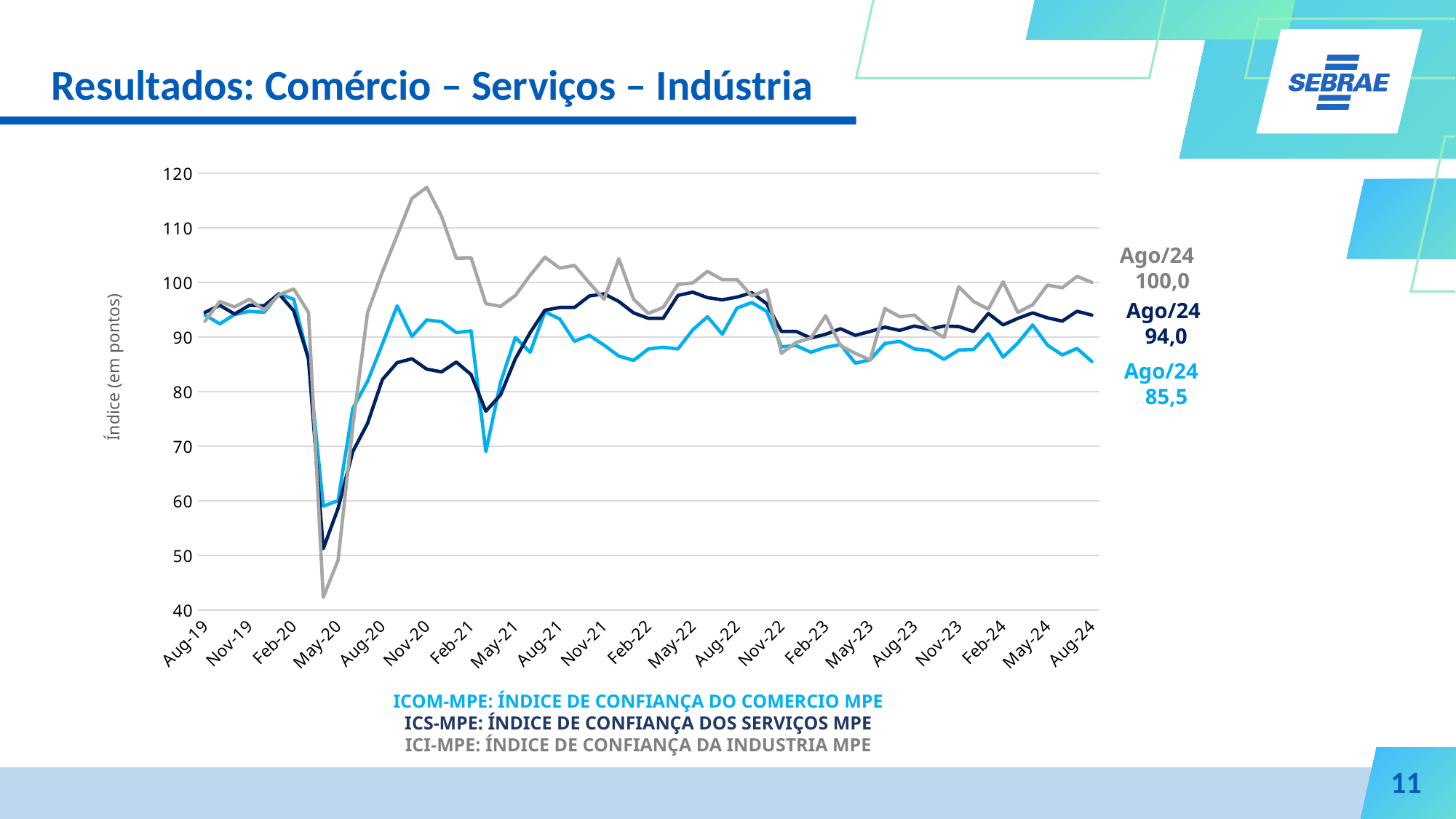
What is the difference between the ICS-MPE and ICOM-MPE values in Ago/24? 8,5 What is the value of ICI-MPE (Índice de Confiança da Indústria MPE) in Ago/24? 100,0 In Ago/24, which is larger: ICS-MPE or ICOM-MPE? ICS-MPE What is the value of ICS-MPE (Índice de Confiança dos Serviços MPE) in Ago/24? 94,0 What kind of chart is shown on the slide? Line chart How many series are plotted on the chart? 3 Which of the three indices has the highest value in Ago/24? ICI-MPE What is the difference between the ICI-MPE and ICOM-MPE values in Ago/24? 14,5 Is the peak of the ICI-MPE line around Nov-20 greater or less than 110? greater Is the lowest value of the ICI-MPE line (around May-20) greater or less than 50? less What is the value of ICOM-MPE (Índice de Confiança do Comercio MPE) in Ago/24? 85,5 Which of the three indices has the lowest value in Ago/24? ICOM-MPE